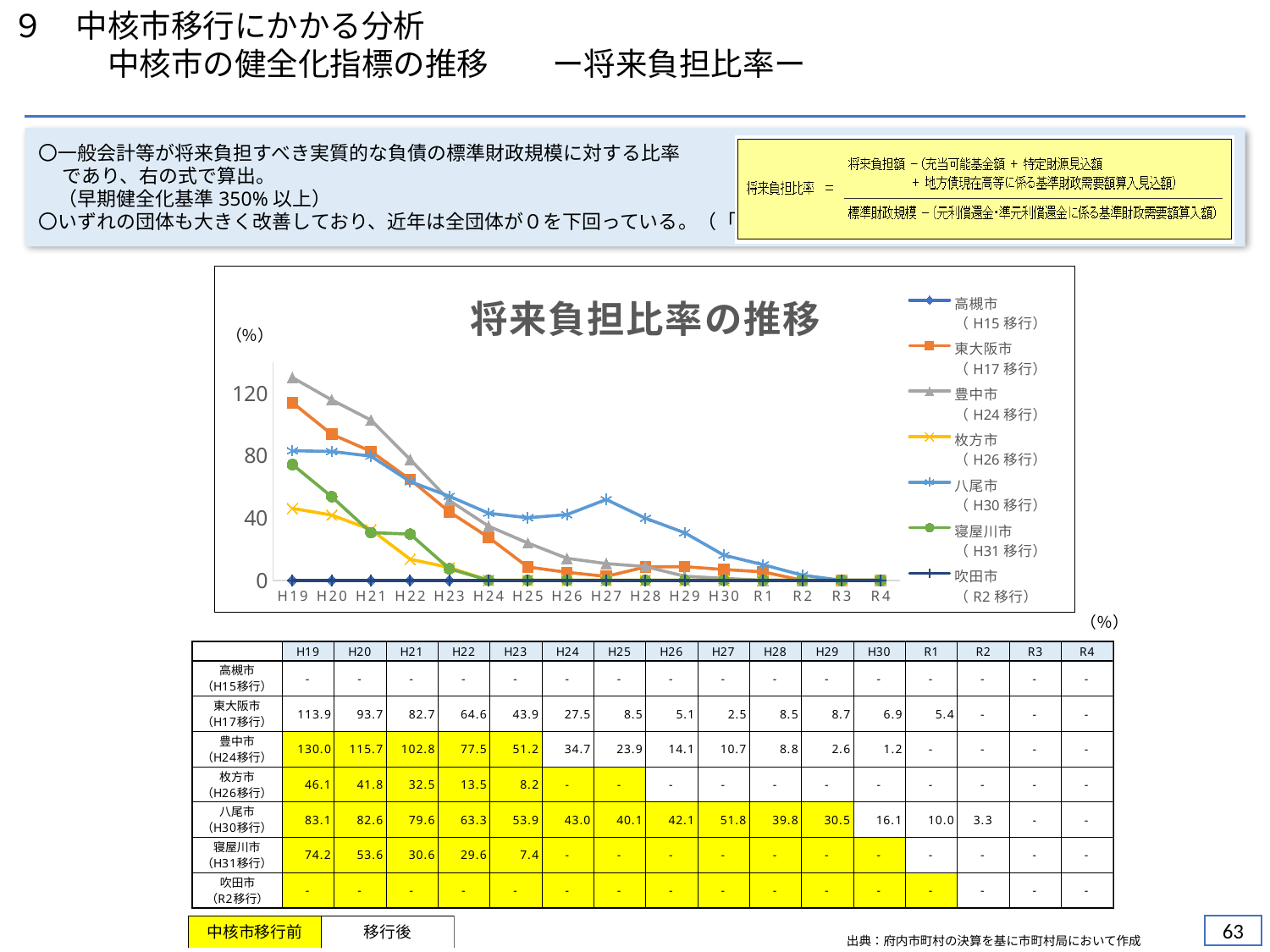
How many series does the legend of 将来負担比率の推移 list? 7 What kind of chart is 将来負担比率の推移? line chart What is the value for 寝屋川市 in H23? 7.4 What unit is shown on the y axis of 将来負担比率の推移? % What is the value for 八尾市 in R2? 3.3 How many points are on the x axis of 将来負担比率の推移 (from H19 to R4)? 16 Which city has the highest value in H19? 豊中市 Does the value for 東大阪市 rise or fall from H19 to H25? fall What is the difference between 東大阪市 (113.9) and 八尾市 (83.1) in H19? 30.8 What is the value for 豊中市 in H19? 130.0 Is the value for 豊中市 in H19 greater or less than 120? greater In H27, which is larger: the value for 八尾市 or the value for 東大阪市? 八尾市